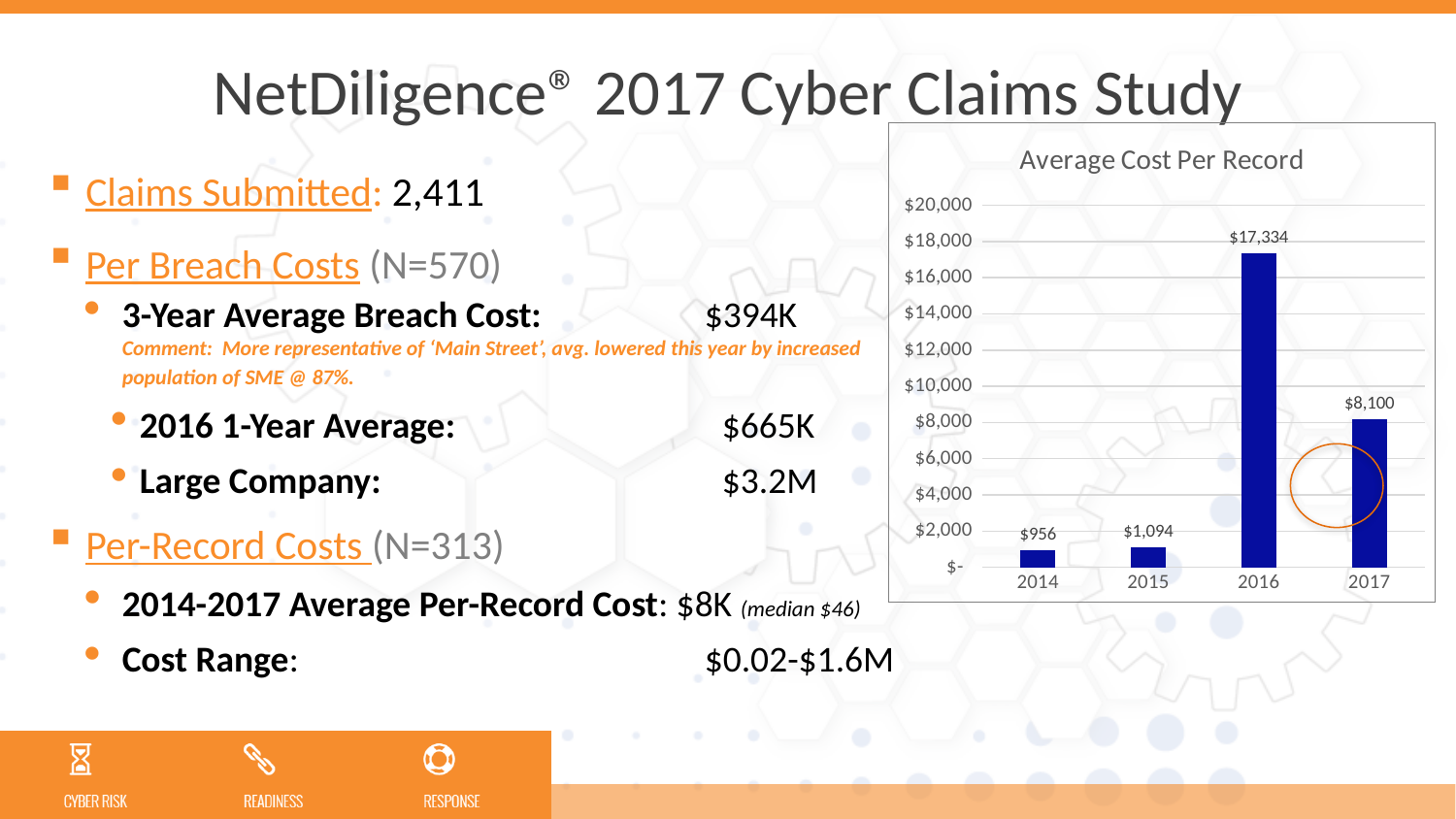
What kind of chart is used to show the average cost per record? bar chart What is the average cost per record for 2014? $956 What is the average cost per record for 2017? $8,100 Which year has the highest average cost per record? 2016 What is the average cost per record for 2016? $17,334 What is the difference between the average cost per record in 2016 and 2017? $9,234 Which year has a higher average cost per record, 2015 or 2017? 2017 How many years are shown on the x axis of the chart? 4 Which year has the lowest average cost per record? 2014 What is the difference between the average cost per record in 2015 and 2014? $138 What is the title of the chart? Average Cost Per Record Is the value for 2017 greater or less than $10,000? less